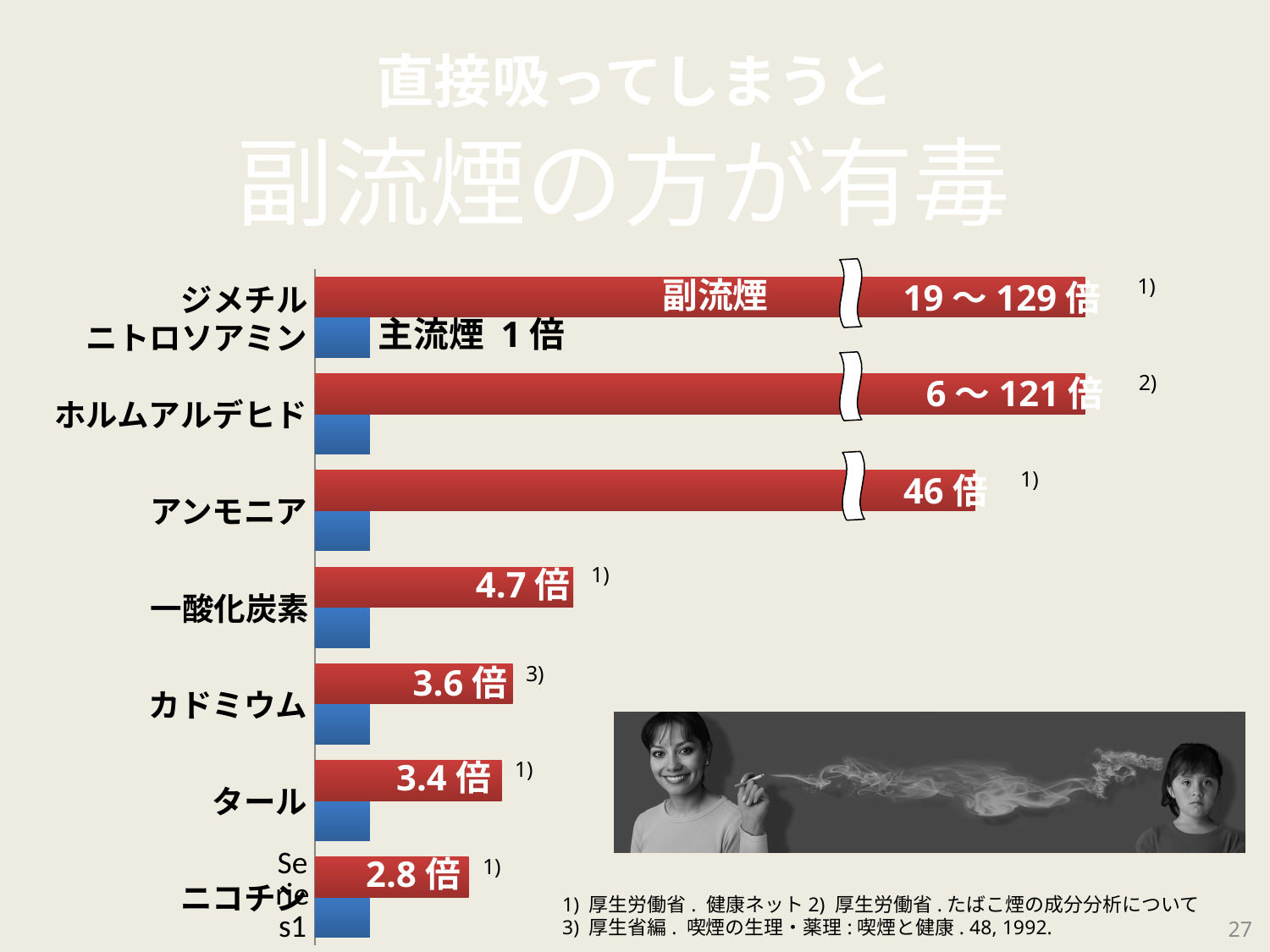
Which substance has the lowest 副流煙 value on the chart? ニコチン What range is labelled for 副流煙 for ホルムアルデヒド? 6～121倍 How many data series does the chart show (red and blue bars)? 2 What kind of chart is shown on the slide? bar chart What is the 副流煙 value labelled for アンモニア? 46倍 What is the difference between the 副流煙 values for 一酸化炭素 and ニコチン? 1.9倍 How many substances (categories) are listed on the chart? 7 What is the 副流煙 value labelled for カドミウム? 3.6倍 What value is labelled for 主流煙 on the chart? 1倍 What is the 副流煙 value labelled for ニコチン? 2.8倍 Which is larger, the 副流煙 value for タール or for 一酸化炭素? 一酸化炭素 What is the 副流煙 value labelled for 一酸化炭素? 4.7倍